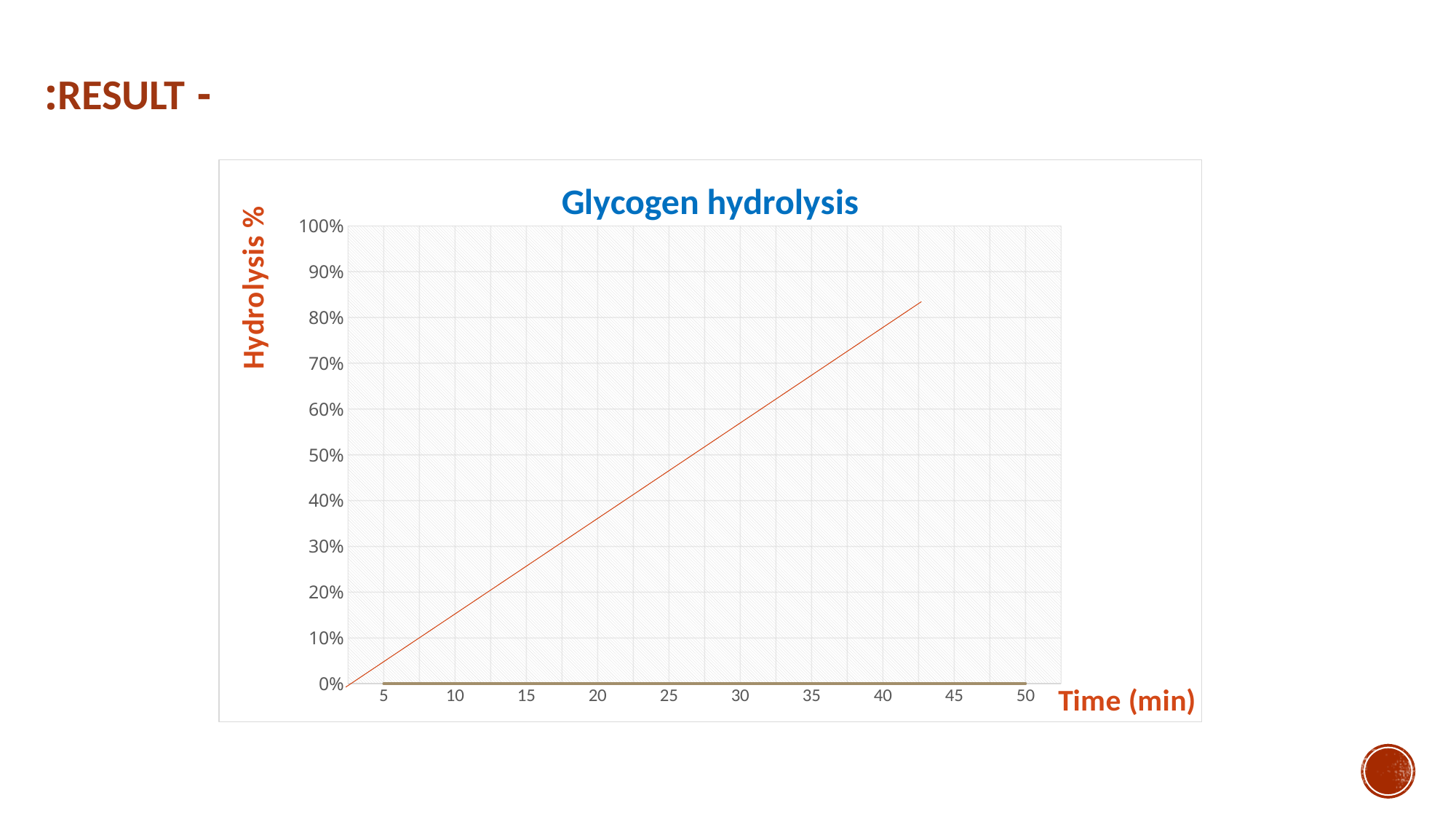
Is the hydrolysis value at 20 min greater or less than 30%? greater Is the hydrolysis value at 40 min greater or less than 70%? greater Does the hydrolysis percentage rise or fall as time increases along the x axis? rise Is the highest hydrolysis value reached by the line greater or less than 90%? less What kind of chart is shown on the slide? line chart Is the hydrolysis value at 30 min larger than the value at 10 min? yes What is the label of the vertical axis? Hydrolysis % What is the title of the chart? Glycogen hydrolysis